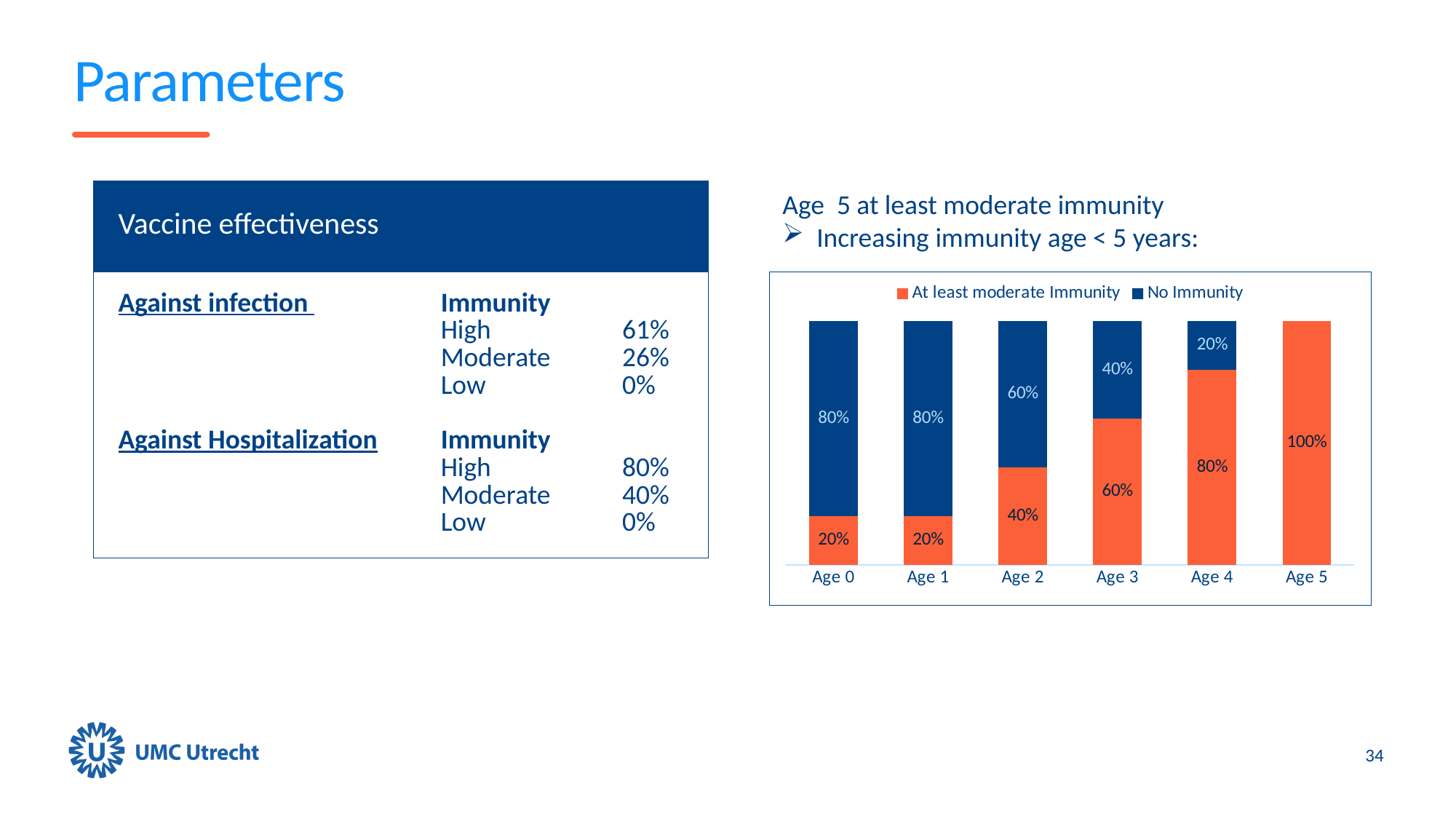
Which is larger: No Immunity for Age 2 or No Immunity for Age 4? No Immunity for Age 2 What is the value of At least moderate Immunity for Age 2? 40% Which age has the highest value for At least moderate Immunity? Age 5 What kind of chart is shown? Stacked bar chart What is the value of No Immunity for Age 0? 80% Which age has the lowest value for No Immunity among ages with a No Immunity segment? Age 4 How many series does the legend list? 2 What is the value of No Immunity for Age 3? 40% What is the value of At least moderate Immunity for Age 5? 100% Does the At least moderate Immunity value rise or fall from Age 0 to Age 5? Rise How many age categories are shown on the x axis? 6 What is the difference between the At least moderate Immunity values for Age 4 and Age 1? 60%